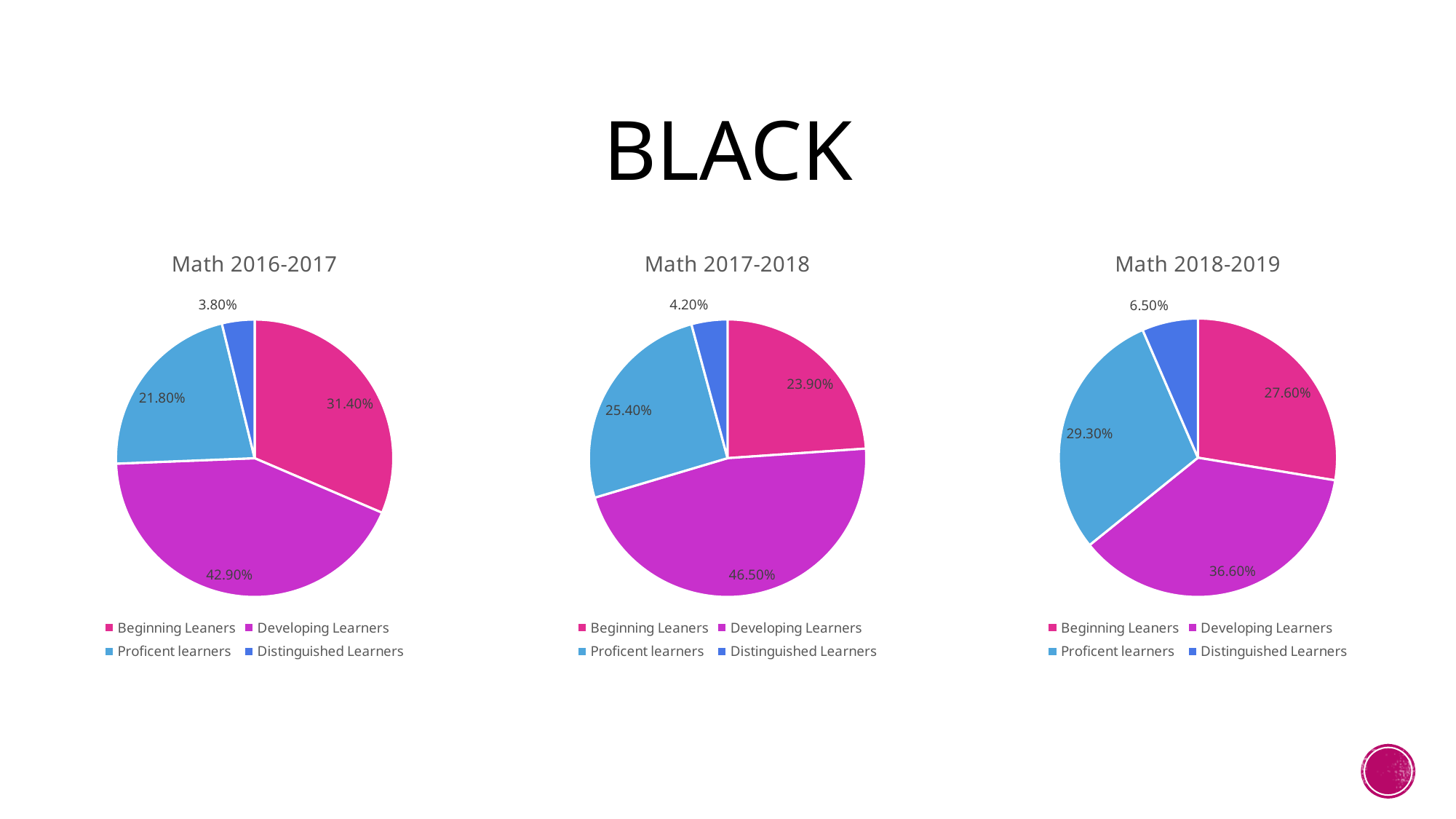
In the Math 2016-2017 chart, what is the difference between the Developing Learners and Beginning Leaners percentages? 11.50% What is the title of the chart on the far right of the slide? Math 2018-2019 In the Math 2018-2019 chart, what percentage is shown for Distinguished Learners? 6.50% In the Math 2018-2019 chart, which is larger: Beginning Leaners or Proficent learners? Proficent learners How many entries does the legend of the Math 2018-2019 chart list? 4 What type of chart is used for Math 2016-2017? Pie chart In the Math 2017-2018 chart, what percentage is shown for Beginning Leaners? 23.90% In the Math 2018-2019 chart, which category has the largest slice? Developing Learners In the Math 2016-2017 chart, which category has the smallest slice? Distinguished Learners In the Math 2016-2017 chart, what percentage is shown for Developing Learners? 42.90% In the Math 2017-2018 chart, what percentage is shown for Proficent learners? 25.40% How many slices does the Math 2017-2018 pie chart have? 4